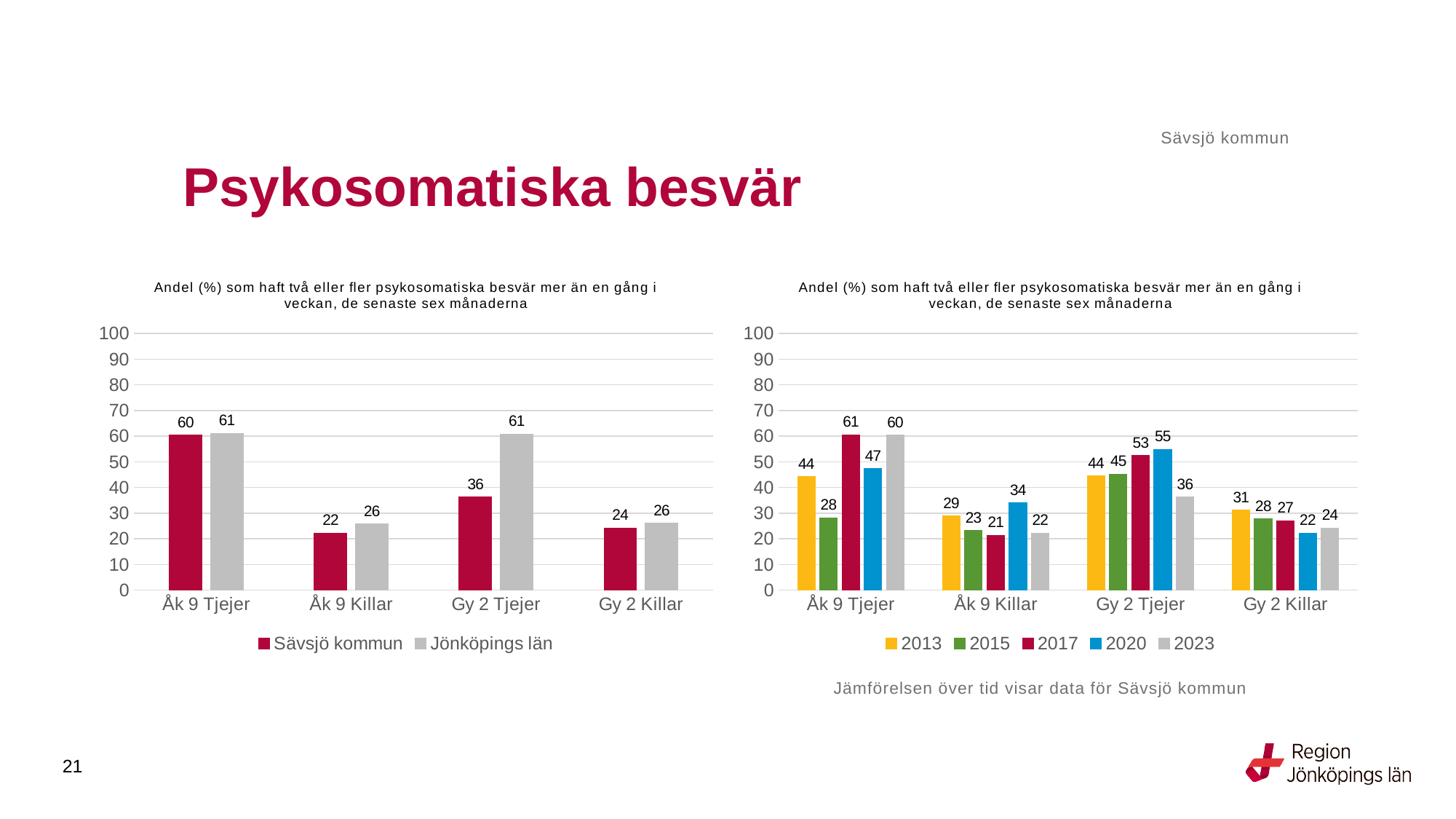
What kind of chart is the left chart? Bar chart In the left chart, how many series does the legend list? 2 In the left chart, what is the value for Sävsjö kommun for Åk 9 Tjejer? 60 In the right chart, how many categories are shown on the x axis? 4 In the right chart, is the value for 2015 for Gy 2 Killar larger or smaller than the value for 2020 for Gy 2 Killar? larger In the left chart, which category has the lowest value for Sävsjö kommun? Åk 9 Killar In the right chart, which year has the highest value for Åk 9 Tjejer? 2017 In the left chart, what is the difference between Jönköpings län and Sävsjö kommun for Gy 2 Tjejer? 25 In the right chart, how many series does the legend list? 5 In the right chart, what is the value for 2013 for Åk 9 Killar? 29 In the left chart, what is the value for Jönköpings län for Gy 2 Tjejer? 61 In the right chart, what is the value for 2020 for Gy 2 Tjejer? 55